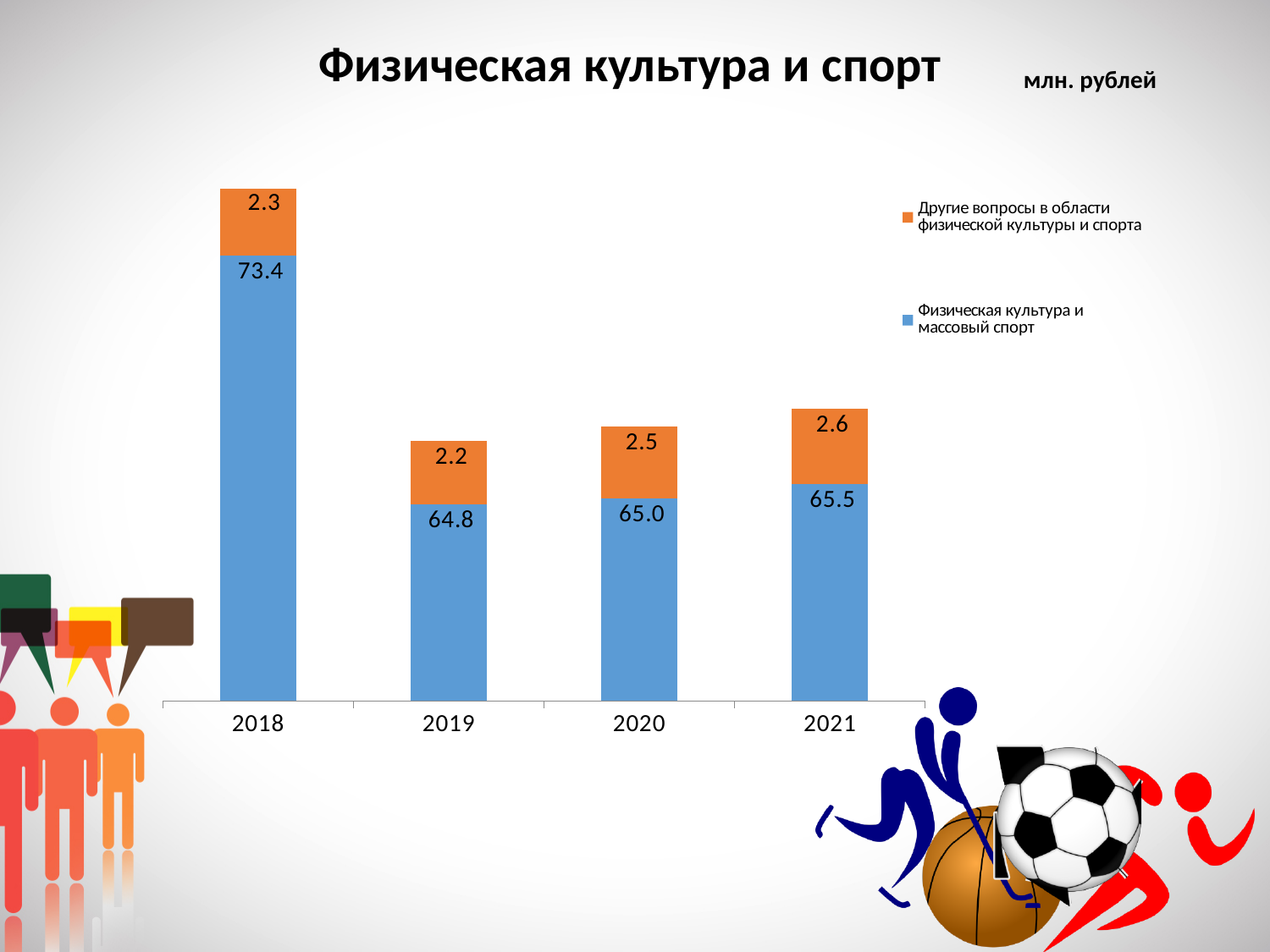
Is the "Другие вопросы в области физической культуры и спорта" value larger in 2020 or in 2021? 2021 Which year has the lowest value for "Другие вопросы в области физической культуры и спорта"? 2019 What is the total of the stacked bar for 2021? 68.1 What unit is stated for the values on the slide? млн. рублей What type of chart is shown on the slide? Stacked bar chart What is the difference between the "Физическая культура и массовый спорт" values for 2018 and 2019? 8.6 How many years are shown on the x axis? 4 Which year has the highest value for "Физическая культура и массовый спорт"? 2018 What is the value for "Другие вопросы в области физической культуры и спорта" in 2021? 2.6 What is the value for "Физическая культура и массовый спорт" in 2018? 73.4 How many series does the legend list? 2 What is the value for "Физическая культура и массовый спорт" in 2020? 65.0